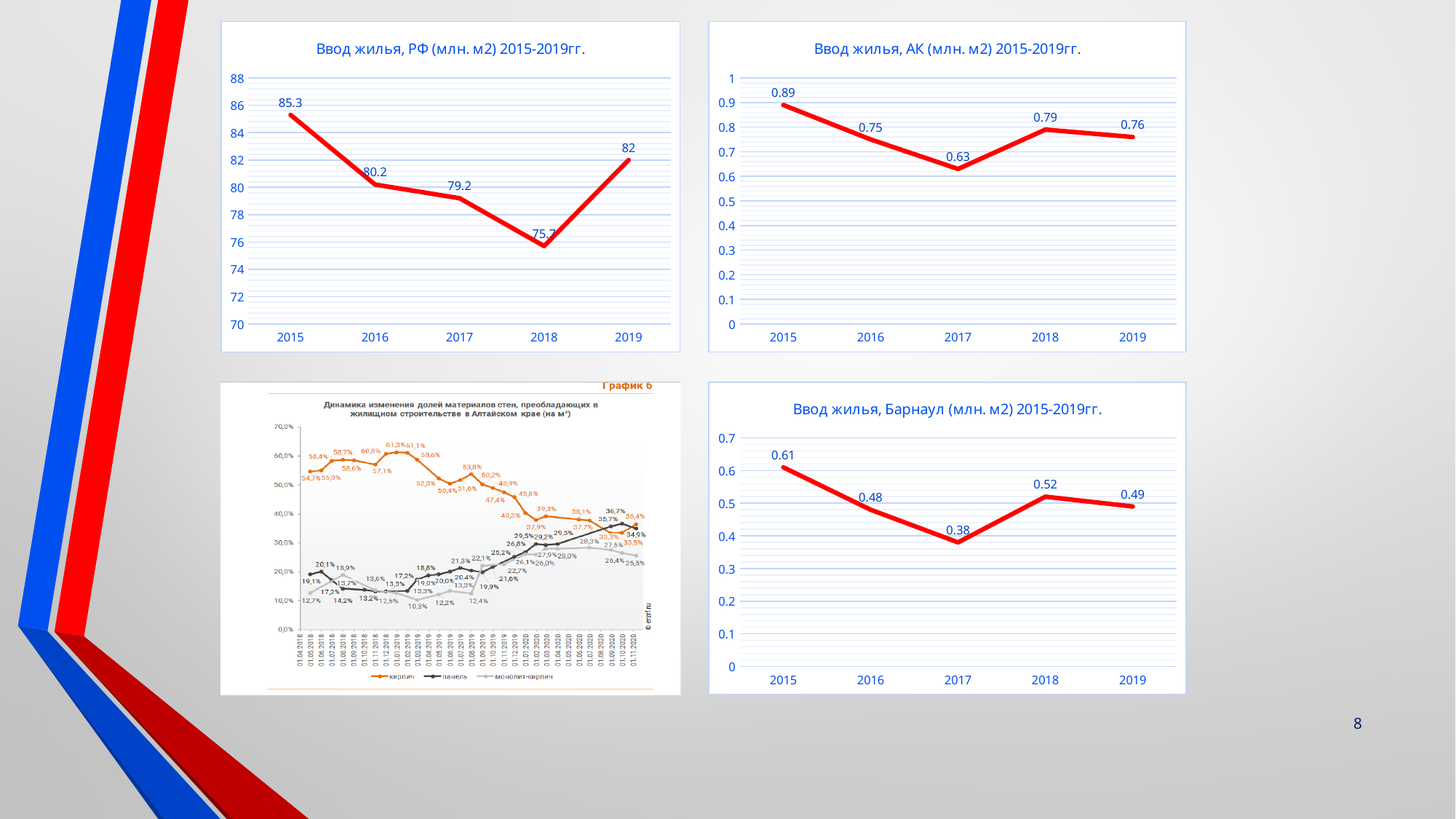
In the chart titled 'Ввод жилья, АК (млн. м2) 2015-2019гг.', is the value for 2018 larger or the value for 2019? 2018 In the chart titled 'Ввод жилья, Барнаул (млн. м2) 2015-2019гг.', what is the value for 2018? 0.52 In the chart titled 'Ввод жилья, Барнаул (млн. м2) 2015-2019гг.', what is the difference between the 2015 value and the 2017 value? 0.23 In the chart titled 'Ввод жилья, РФ (млн. м2) 2015-2019гг.', what is the value for 2015? 85.3 In the chart titled 'Ввод жилья, АК (млн. м2) 2015-2019гг.', what is the value for 2017? 0.63 In the chart titled 'Ввод жилья, АК (млн. м2) 2015-2019гг.', how many years are plotted? 5 In the chart titled 'Ввод жилья, АК (млн. м2) 2015-2019гг.', which year has the highest value? 2015 In the chart at the bottom left labelled 'График 6', how many series does the legend list? 3 In the chart titled 'Ввод жилья, РФ (млн. м2) 2015-2019гг.', what kind of chart is shown? line chart In the chart titled 'Ввод жилья, РФ (млн. м2) 2015-2019гг.', which year has the lowest value? 2018 In the chart titled 'Ввод жилья, Барнаул (млн. м2) 2015-2019гг.', do the values rise or fall from 2015 to 2017? fall In the chart titled 'Ввод жилья, РФ (млн. м2) 2015-2019гг.', what is the difference between the 2015 value and the 2018 value? 9.6